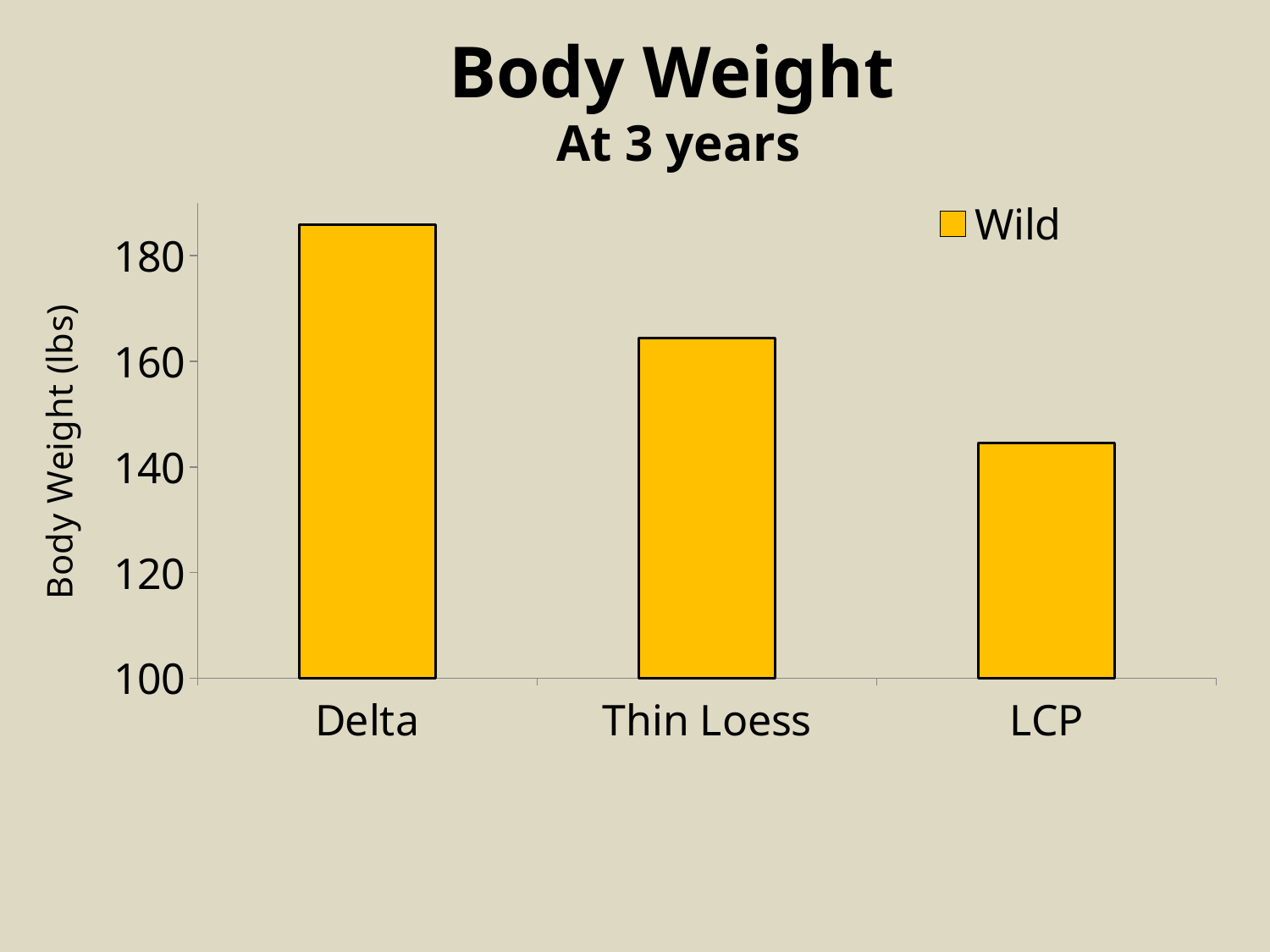
Which has a larger body weight, Delta or Thin Loess? Delta Is the value for Thin Loess greater or less than 180? less How many series does the legend list? 1 Is the value for LCP greater or less than 160? less Which category has the lowest body weight? LCP Is the value for Delta greater or less than 180? greater Which category has the highest body weight? Delta Which has a larger body weight, Thin Loess or LCP? Thin Loess Do the values rise or fall from left to right across the categories? fall What is the title of the chart? Body Weight At 3 years What kind of chart is shown on the slide? bar chart How many categories are shown on the x axis of the chart? 3